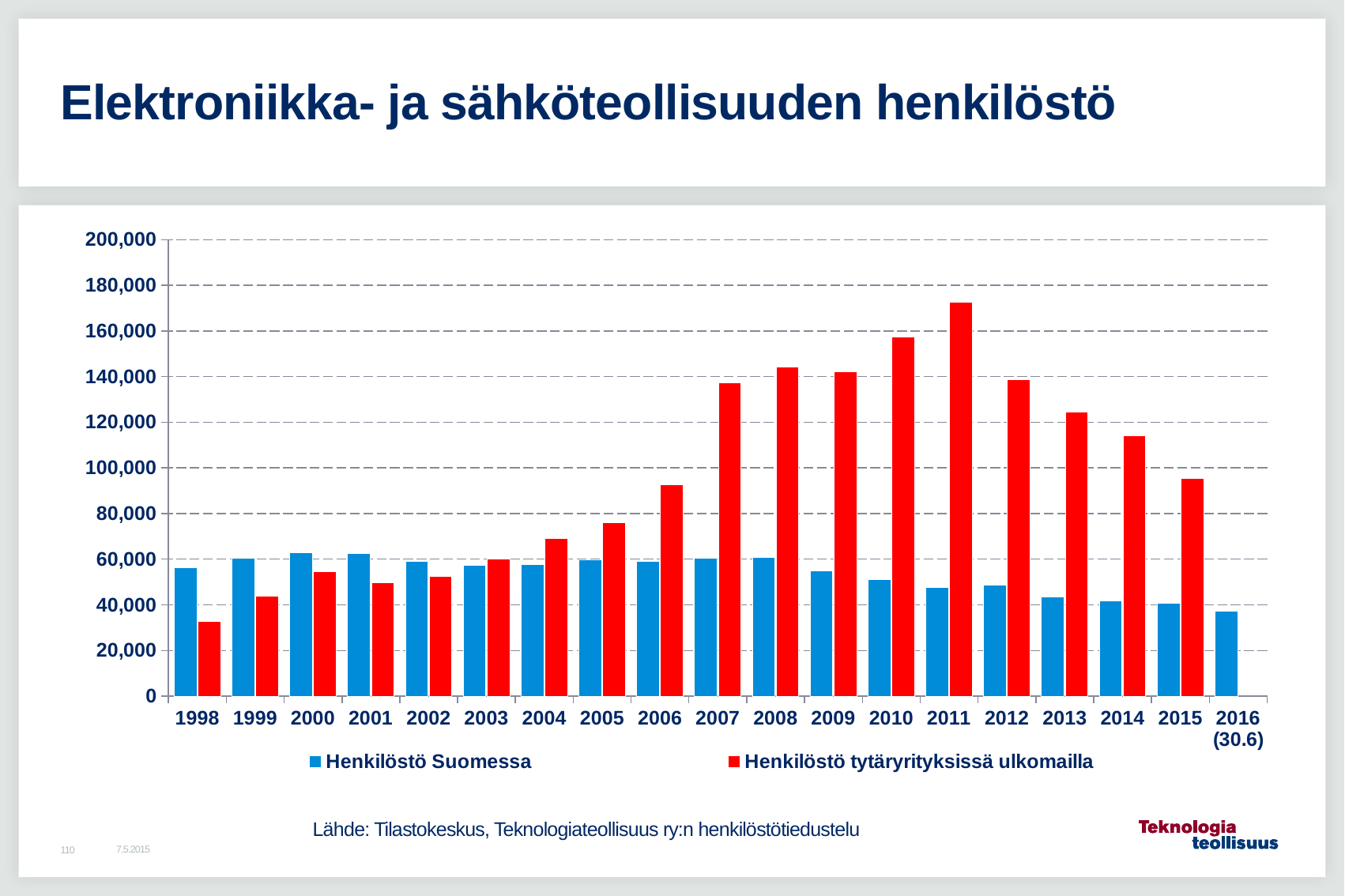
In which year is the value for Henkilöstö Suomessa lowest? 2016 (30.6) In which year is the value for Henkilöstö tytäryrityksissä ulkomailla highest? 2011 Is the value for Henkilöstö tytäryrityksissä ulkomailla in 1998 greater or less than 40,000? less In which year is the value for Henkilöstö tytäryrityksissä ulkomailla lowest? 1998 How many years (categories) are shown on the x axis? 19 Is the value for Henkilöstö Suomessa in 2000 greater or less than 60,000? greater In 2006, which is larger: Henkilöstö Suomessa or Henkilöstö tytäryrityksissä ulkomailla? Henkilöstö tytäryrityksissä ulkomailla Do the values for Henkilöstö tytäryrityksissä ulkomailla rise or fall from 2011 to 2015? fall How many series does the legend list? 2 Is the value for Henkilöstö Suomessa in 2016 (30.6) greater or less than 40,000? less What kind of chart is shown on the slide? Bar chart